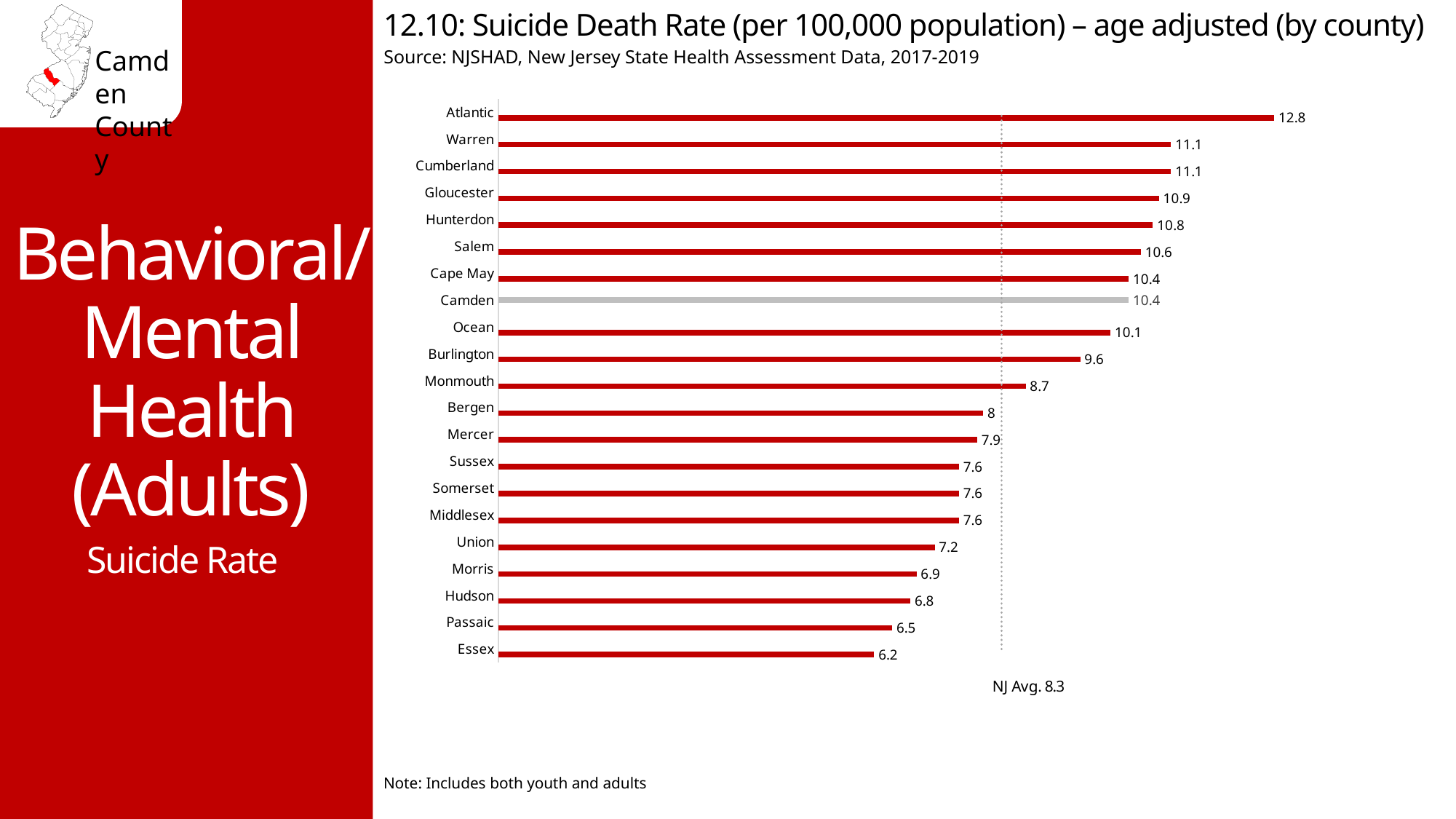
What is the difference between the suicide death rates of Atlantic and Essex counties? 6.6 What is the suicide death rate for Camden county? 10.4 Which county has the highest suicide death rate? Atlantic What is the difference between the suicide death rates of Camden and Monmouth counties? 1.7 Which county has a higher suicide death rate, Gloucester or Bergen? Gloucester What is the suicide death rate for Atlantic county? 12.8 Which county's bar is shown in gray instead of red? Camden What type of chart is shown on the slide? Bar chart Which county has the lowest suicide death rate? Essex What is the NJ average suicide death rate shown on the chart? 8.3 How many counties are shown in the chart? 21 What is the suicide death rate for Essex county? 6.2